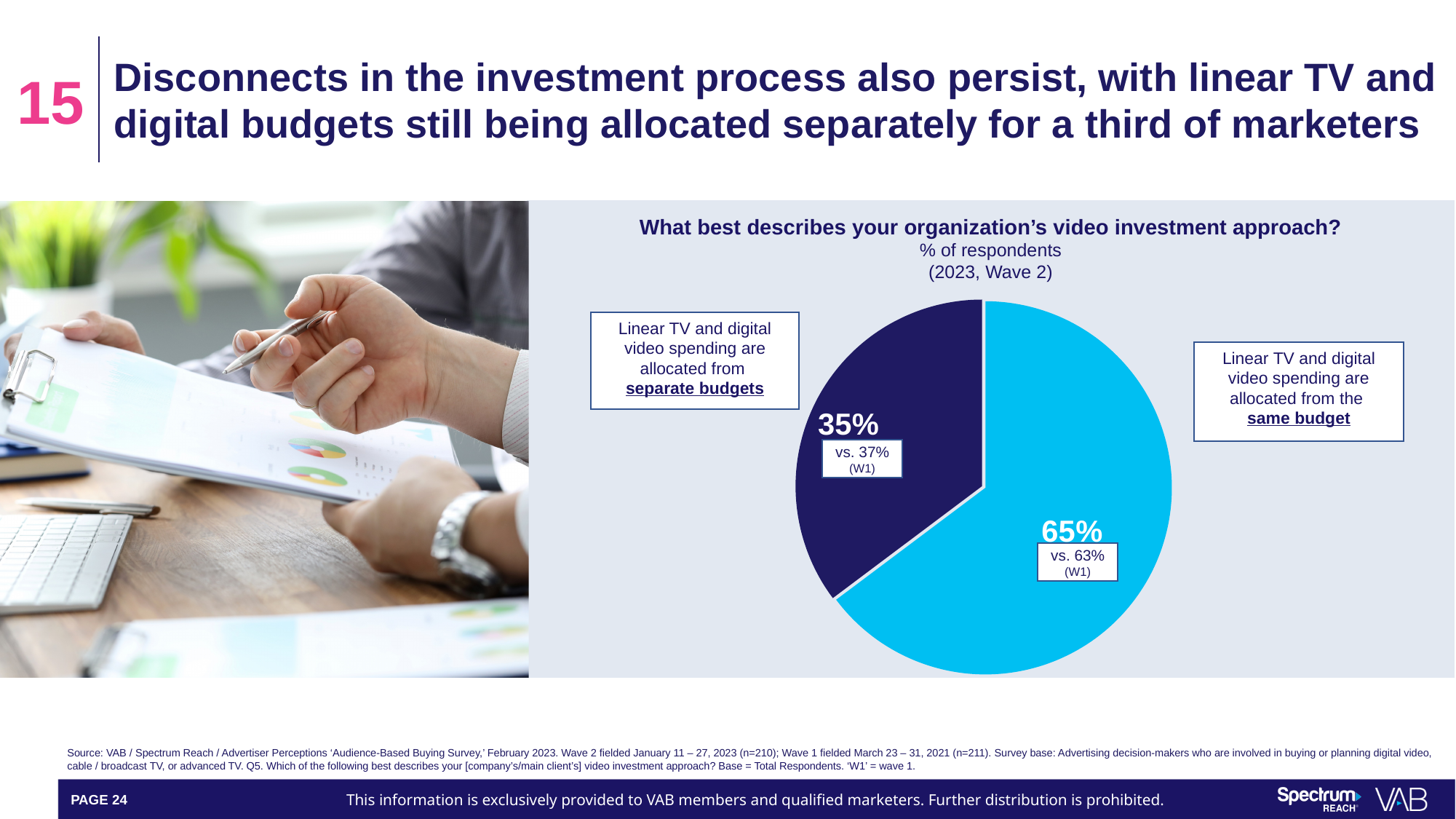
Which category has the smaller share of the pie? Linear TV and digital video spending are allocated from separate budgets What was the Wave 1 value for respondents allocating from separate budgets? 37% What percentage of respondents allocate linear TV and digital video spending from the same budget? 65% What is the title of the chart? What best describes your organization's video investment approach? What was the Wave 1 value for respondents allocating from the same budget? 63% What percentage of respondents allocate linear TV and digital video spending from separate budgets? 35% Which category has the larger share of the pie? Linear TV and digital video spending are allocated from the same budget Which wave and year does the pie chart show? 2023, Wave 2 Is the 'same budget' share larger or smaller than the 'separate budgets' share? Larger How many slices does the pie chart have? 2 What is the difference in percentage points between the 'same budget' share and the 'separate budgets' share? 30 What kind of chart is shown on the slide? Pie chart